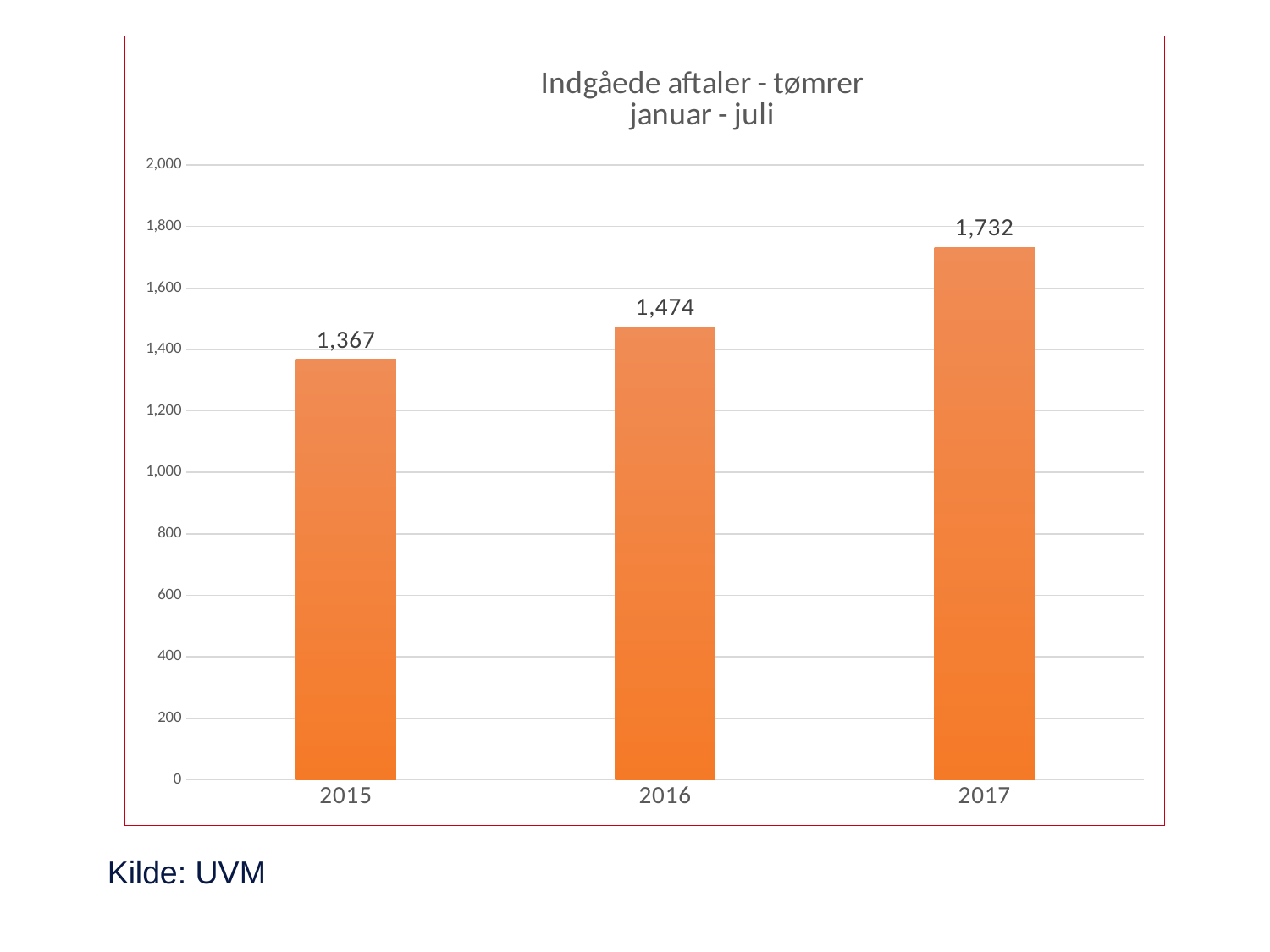
What is the value for 2016? 1,474 Is the value for 2017 greater or less than 1,600? greater What is the difference between the values for 2016 and 2015? 107 What is the difference between the values for 2017 and 2015? 365 Do the values rise or fall from 2015 to 2017? rise Which is larger, the value for 2016 or the value for 2017? 2017 How many years are shown on the x axis? 3 Which year has the lowest value? 2015 What kind of chart is this? bar chart What is the value for 2015? 1,367 Which year has the highest value? 2017 What is the value for 2017? 1,732